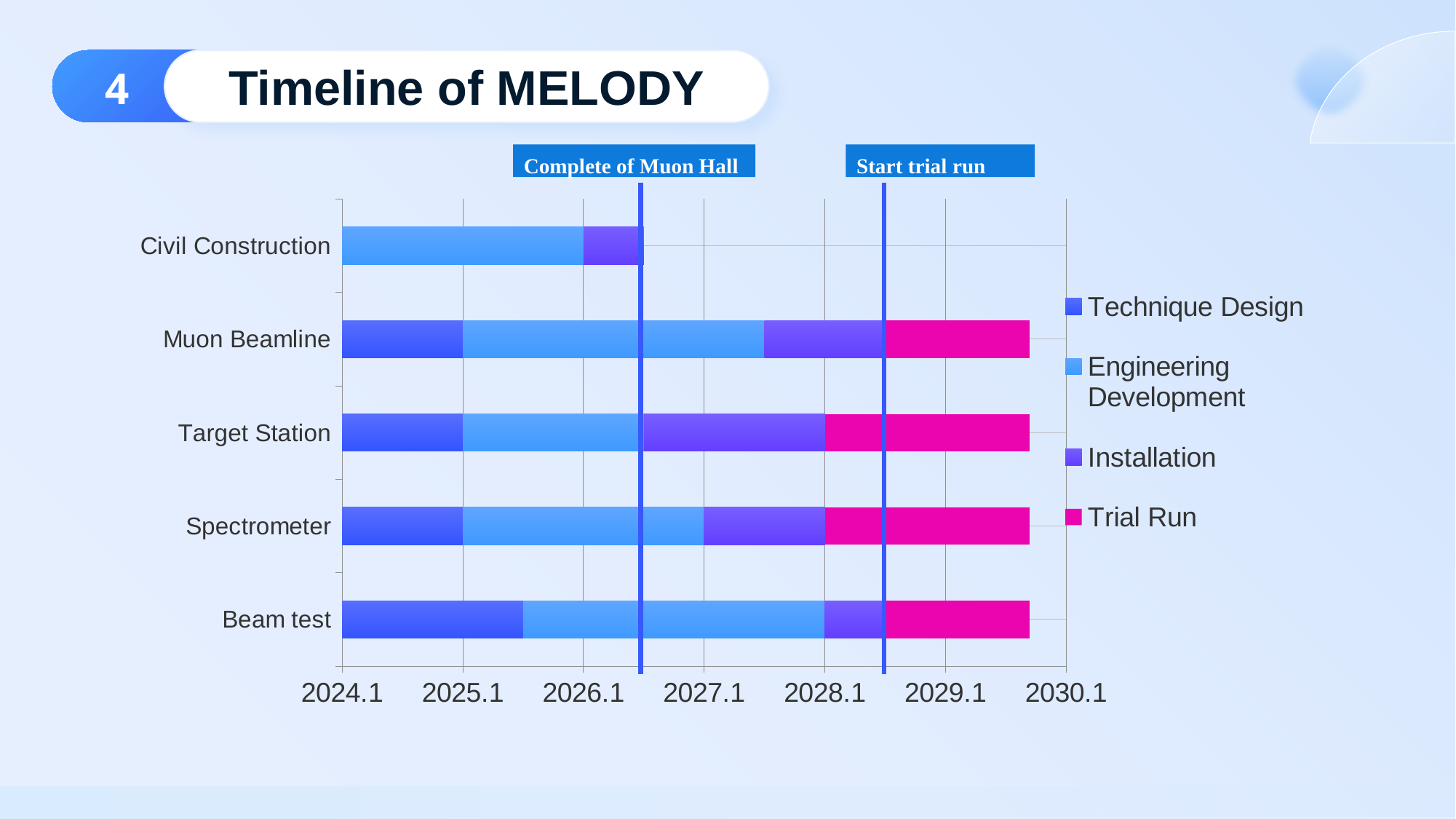
How many series does the legend list? 4 What kind of chart is shown on the slide? Stacked bar chart Is the end of the Technique Design segment for Beam test greater or less than 2025.1? greater Which category has the longest Installation segment? Target Station What milestone label is attached to the first vertical line on the chart? Complete of Muon Hall Which category has no Technique Design segment? Civil Construction What is the title of the slide containing the chart? Timeline of MELODY How many categories (rows) are shown on the chart? 5 Which category has the longest Technique Design segment? Beam test Which category has no Trial Run segment? Civil Construction Is the end of the Civil Construction bar greater or less than 2027.1? less Which category's bar ends earliest on the time axis? Civil Construction